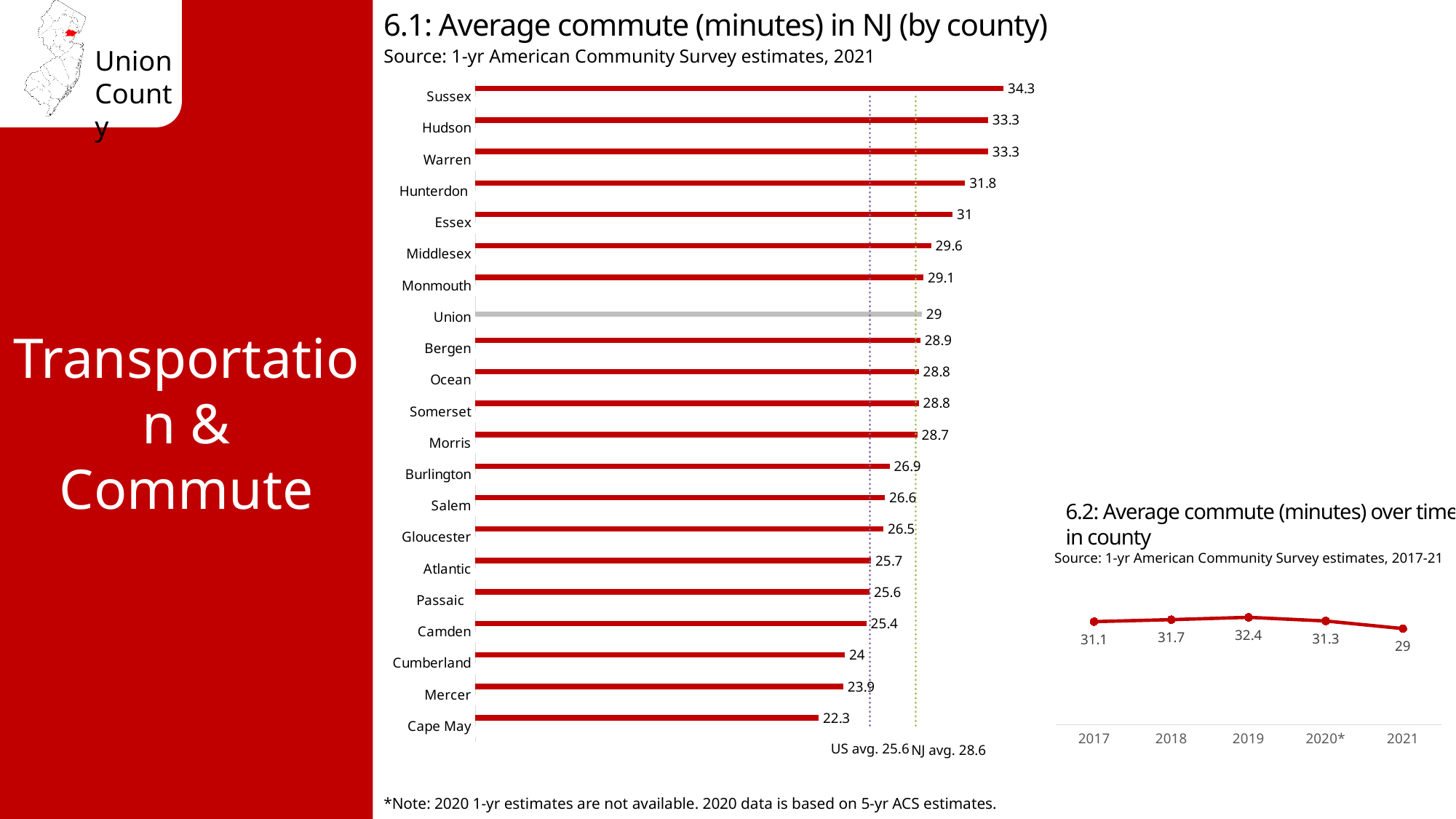
In chart 6.1 (Average commute in NJ by county), what is the average commute for Mercer? 23.9 In chart 6.1 (Average commute in NJ by county), which has a longer average commute, Hunterdon or Burlington? Hunterdon In chart 6.1 (Average commute in NJ by county), which county has the highest average commute? Sussex What kind of chart is chart 6.1 (Average commute in NJ by county)? Bar chart In chart 6.2 (Average commute over time in county), which year has the lowest average commute? 2021 In chart 6.1 (Average commute in NJ by county), what is the difference between the average commute for Sussex and Cape May? 12 In chart 6.1 (Average commute in NJ by county), what is the average commute for Union county? 29 In chart 6.1 (Average commute in NJ by county), what is the NJ average commute shown by the reference line? 28.6 In chart 6.2 (Average commute over time in county), what was the average commute in 2019? 32.4 In chart 6.1 (Average commute in NJ by county), which county has the lowest average commute? Cape May In chart 6.2 (Average commute over time in county), what is the difference between the 2019 and 2021 values? 3.4 In chart 6.1 (Average commute in NJ by county), how many counties are shown? 21